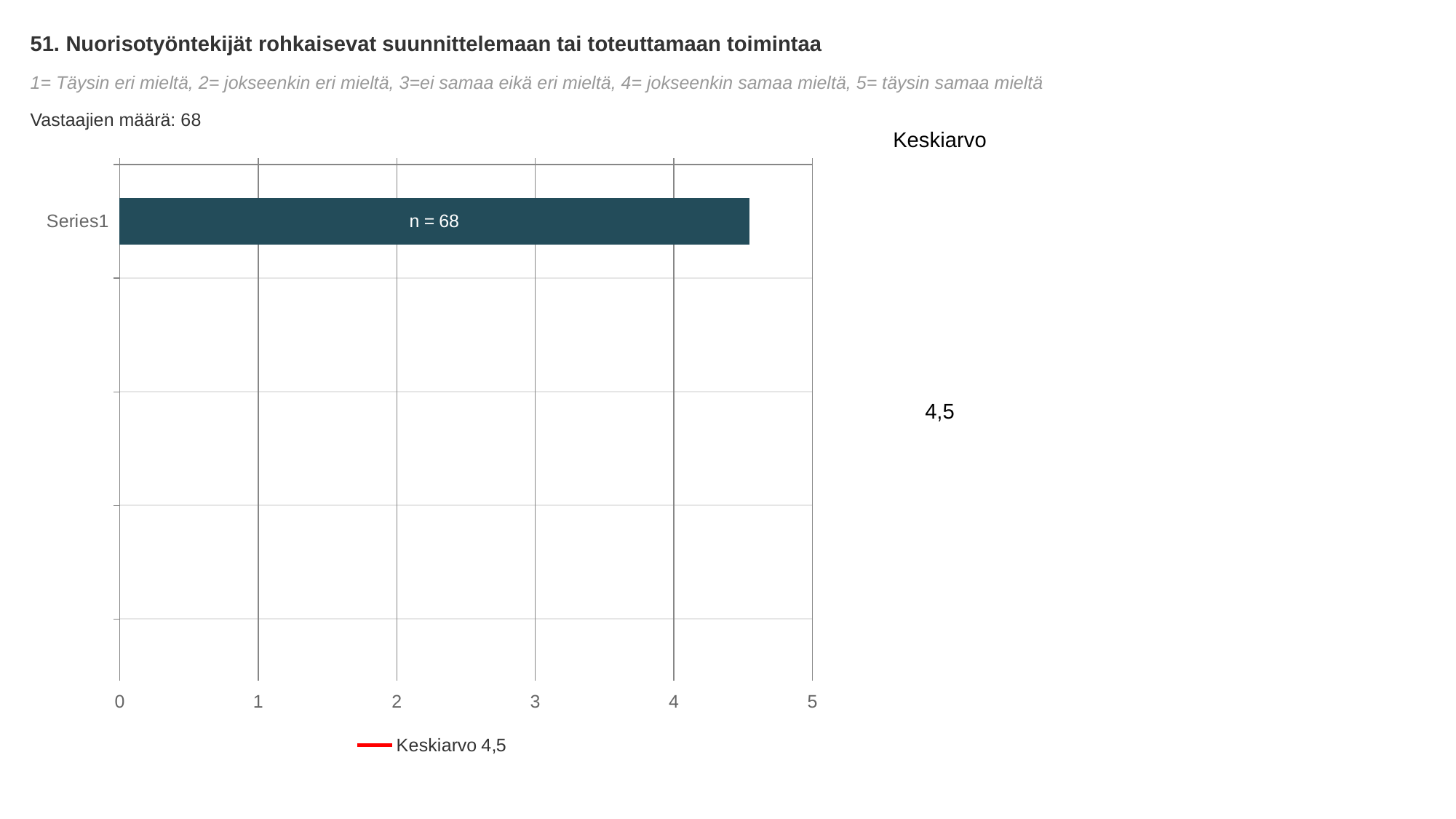
Is the value of the Series1 bar greater or less than 3? greater Is the value of the Series1 bar greater or less than 5? less What kind of chart is shown on the slide? bar chart What is the maximum value shown on the horizontal axis? 5 Is the value of the Series1 bar greater or less than 4? greater What is the label of the single category on the vertical axis? Series1 How many bars are plotted in the chart? 1 What text does the legend entry below the chart show? Keskiarvo 4,5 What is the Keskiarvo (mean) value shown on the slide? 4,5 How many respondents (Vastaajien määrä) are reported on the slide? 68 What data label is printed on the Series1 bar? n = 68